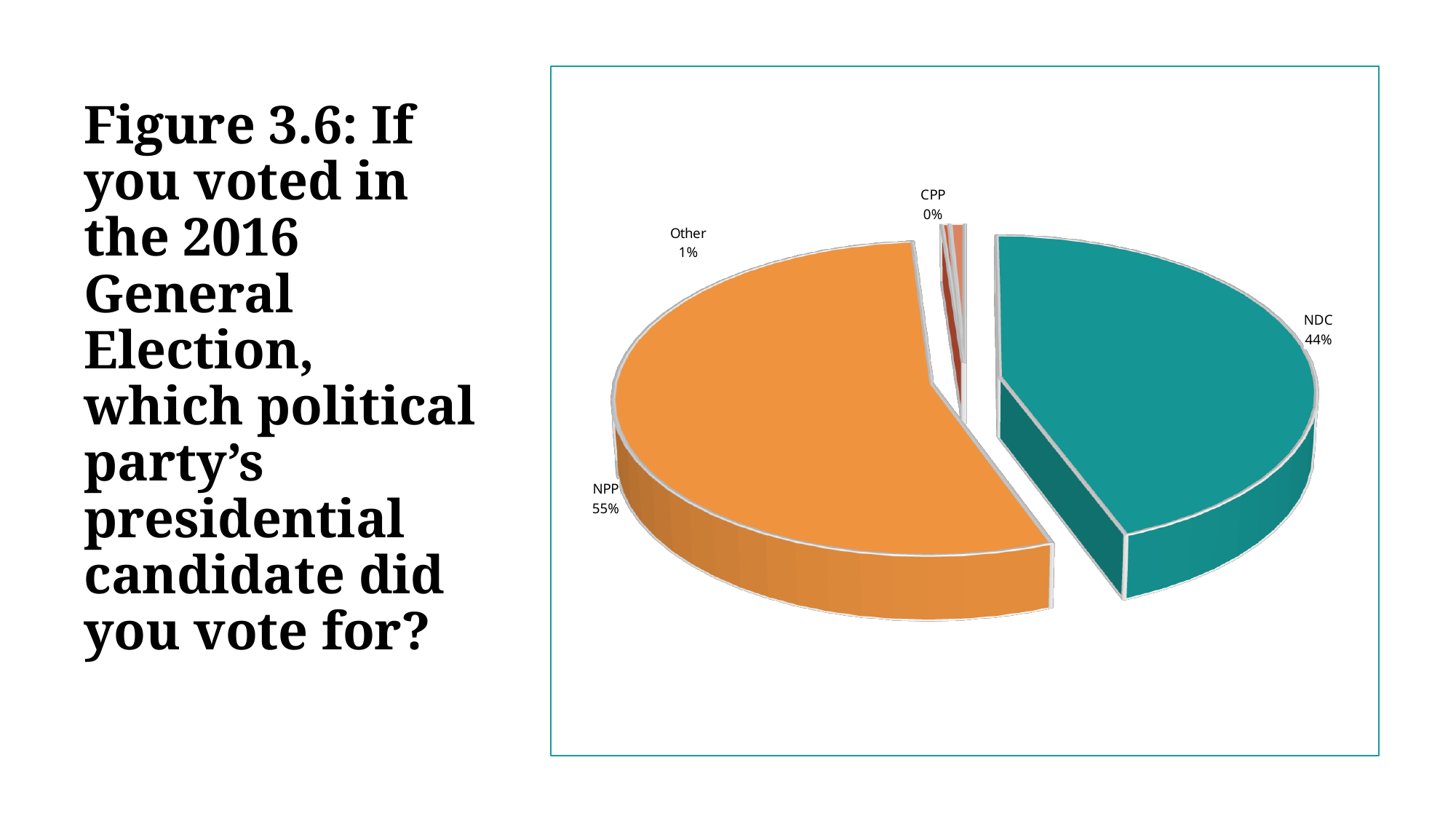
Which labelled party has the smallest slice of the pie? CPP What percentage is shown for Other? 1% What share of the pie does NPP have? 55% What is the figure number given in the slide title? Figure 3.6 What kind of chart is shown on the slide? Pie chart What colour is the NDC slice? Teal Which party has the largest slice of the pie? NPP Which is larger, the NDC slice or the NPP slice? NPP What percentage is shown for CPP? 0% What is the combined share of NPP and NDC? 99% What is the difference in percentage points between NPP and NDC? 11 percentage points What share of the pie does NDC have? 44%